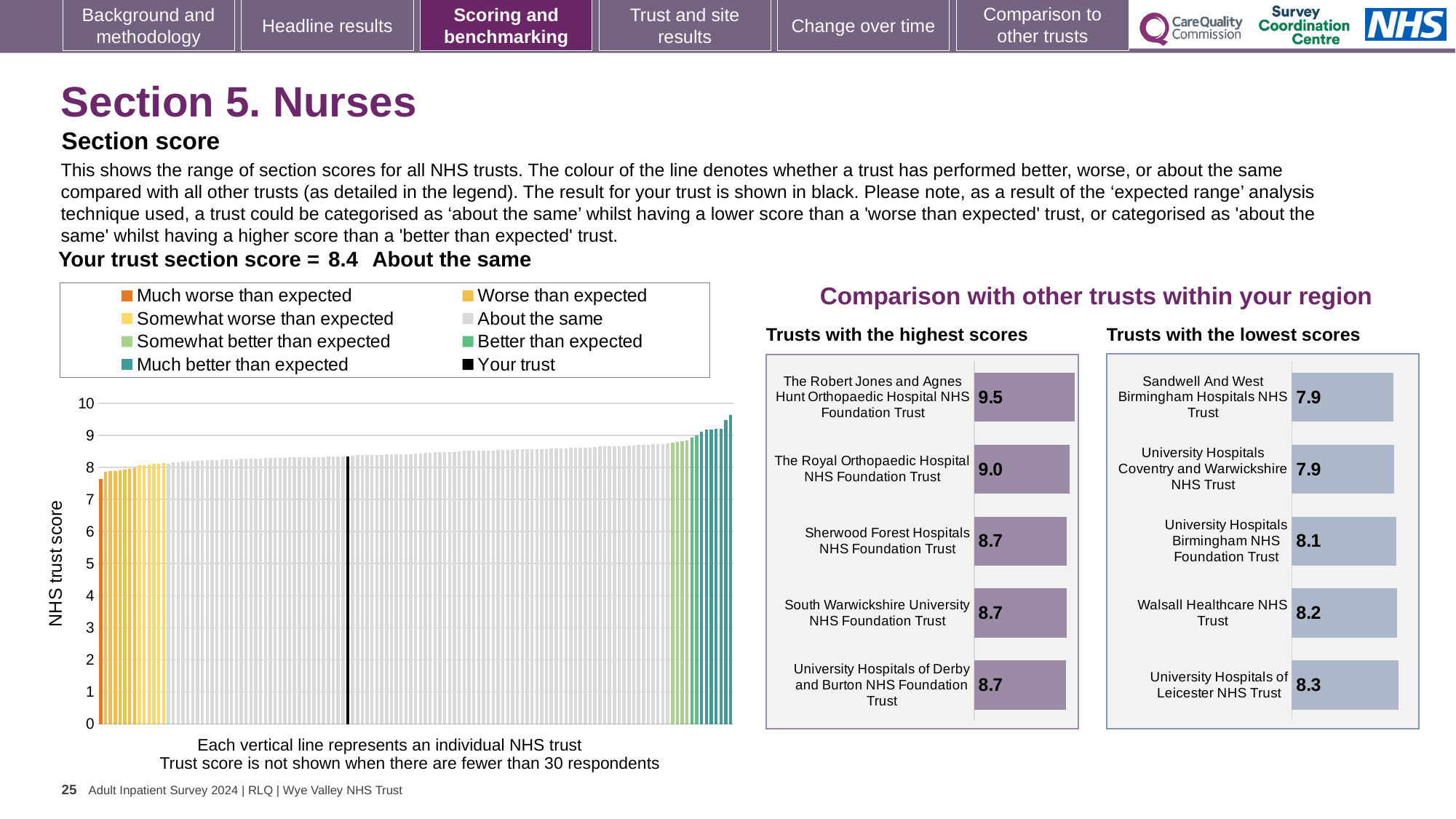
In the 'Trusts with the highest scores' chart, what is the difference between the scores of The Robert Jones and Agnes Hunt Orthopaedic Hospital NHS Foundation Trust and The Royal Orthopaedic Hospital NHS Foundation Trust? 0.5 In the 'Trusts with the highest scores' chart, which trust has the highest score? The Robert Jones and Agnes Hunt Orthopaedic Hospital NHS Foundation Trust In the large chart on the left, do the NHS trust scores rise or fall from left to right? Rise In the 'Trusts with the lowest scores' chart, what is the difference between the scores of University Hospitals of Leicester NHS Trust and University Hospitals Coventry and Warwickshire NHS Trust? 0.4 In the 'Trusts with the highest scores' chart, what is the score for The Royal Orthopaedic Hospital NHS Foundation Trust? 9.0 In the 'Trusts with the highest scores' chart, what is the score for The Robert Jones and Agnes Hunt Orthopaedic Hospital NHS Foundation Trust? 9.5 How many trusts are shown in the 'Trusts with the highest scores' chart? 5 What kind of chart is the large chart on the left showing NHS trust scores? Bar chart In the 'Trusts with the lowest scores' chart, which trust has the highest score? University Hospitals of Leicester NHS Trust In the 'Trusts with the lowest scores' chart, which has the larger score: Walsall Healthcare NHS Trust or University Hospitals Birmingham NHS Foundation Trust? Walsall Healthcare NHS Trust In the 'Trusts with the lowest scores' chart, what is the score for Walsall Healthcare NHS Trust? 8.2 In the 'Trusts with the lowest scores' chart, what is the score for Sandwell And West Birmingham Hospitals NHS Trust? 7.9